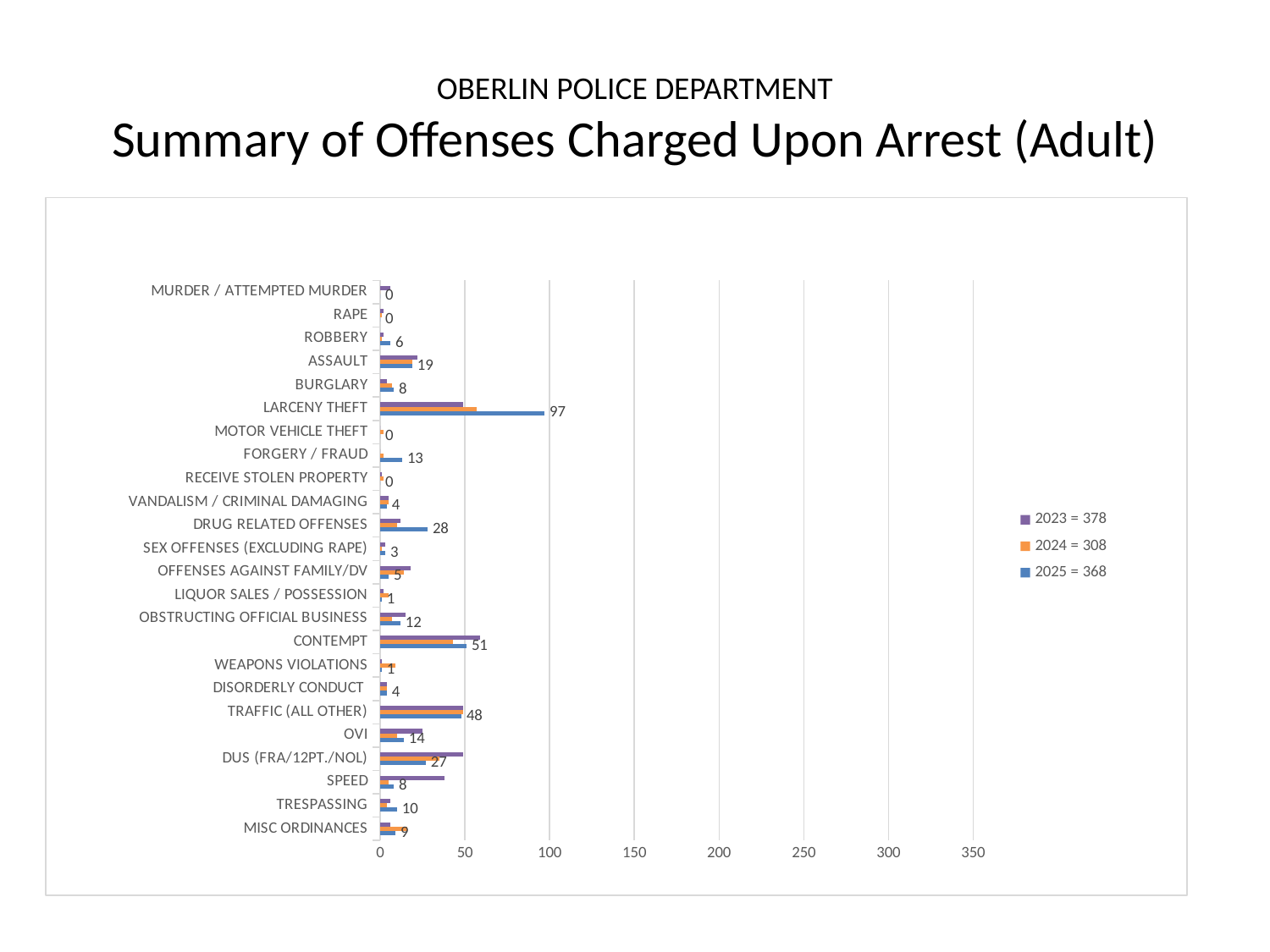
Which offense category has the highest 2025 value? LARCENY THEFT Is the 2023 value for CONTEMPT greater or less than 50? greater According to the legend, what is the total for 2024? 308 What is the 2025 value for DRUG RELATED OFFENSES? 28 What is the 2025 value for CONTEMPT? 51 How many offense categories are listed on the chart? 24 How many series does the legend list? 3 What is the difference between the 2025 values for LARCENY THEFT and CONTEMPT? 46 Which has a larger 2025 value, DUS (FRA/12PT./NOL) or OVI? DUS (FRA/12PT./NOL) What is the 2025 value for TRAFFIC (ALL OTHER)? 48 What is the 2025 value for LARCENY THEFT? 97 What kind of chart is shown on the slide? Bar chart